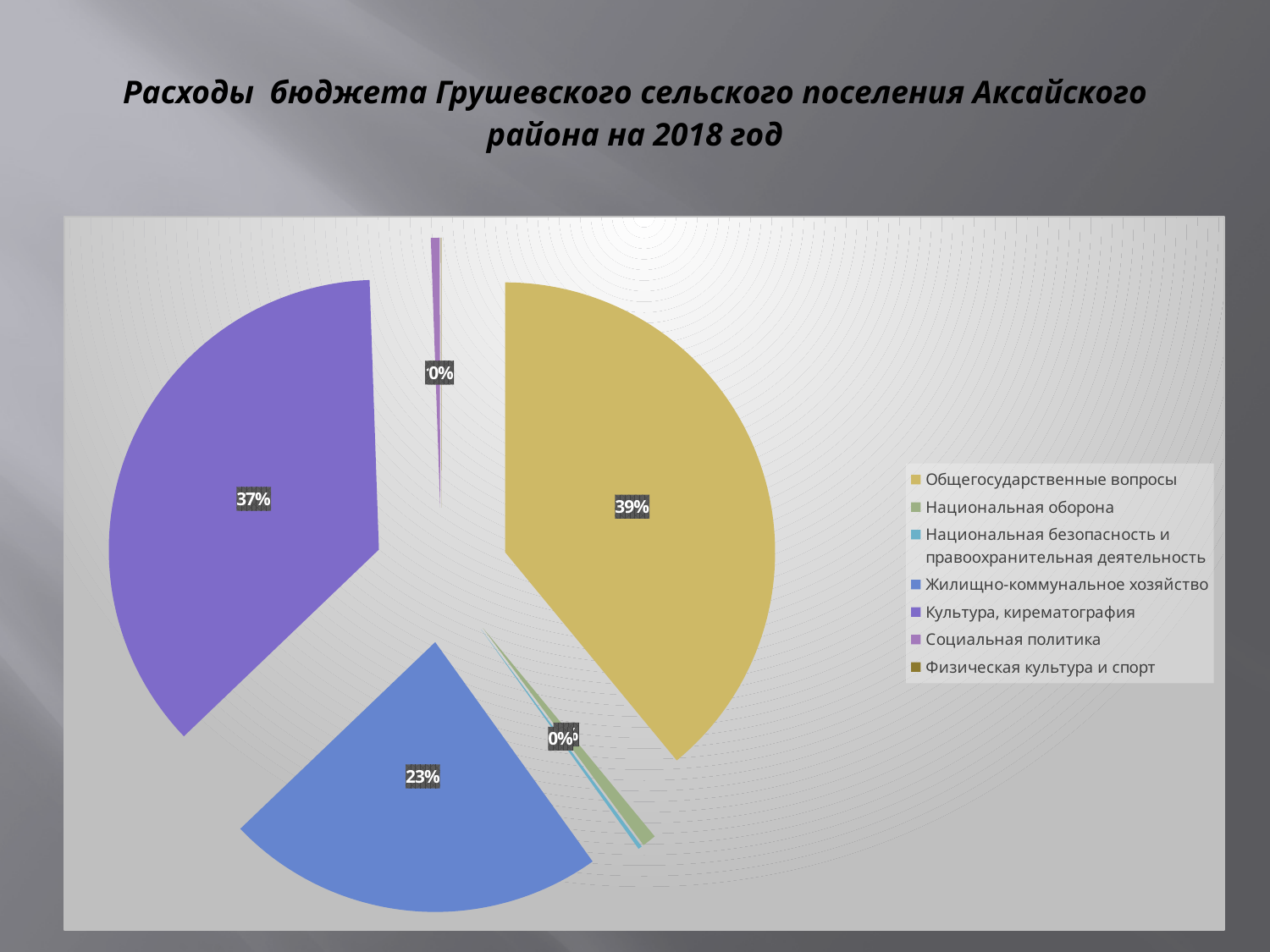
What colour is the slice for Жилищно-коммунальное хозяйство? blue Which category has the largest slice of the pie? Общегосударственные вопросы What is the title of the slide? Расходы бюджета Грушевского сельского поселения Аксайского района на 2018 год What share of the pie does Общегосударственные вопросы take? 39% What is the difference in percentage points between the Общегосударственные вопросы slice and the Жилищно-коммунальное хозяйство slice? 16 What kind of chart is shown on the slide? pie chart What share of the pie does Культура, кирематография take? 37% What is the difference in percentage points between the Культура, кирематография slice and the Жилищно-коммунальное хозяйство slice? 14 How many categories does the legend list? 7 What share of the pie does Жилищно-коммунальное хозяйство take? 23% Which is larger, the slice for Культура, кирематография or the slice for Жилищно-коммунальное хозяйство? Культура, кирематография Which is larger, the slice for Общегосударственные вопросы or the slice for Культура, кирематография? Общегосударственные вопросы